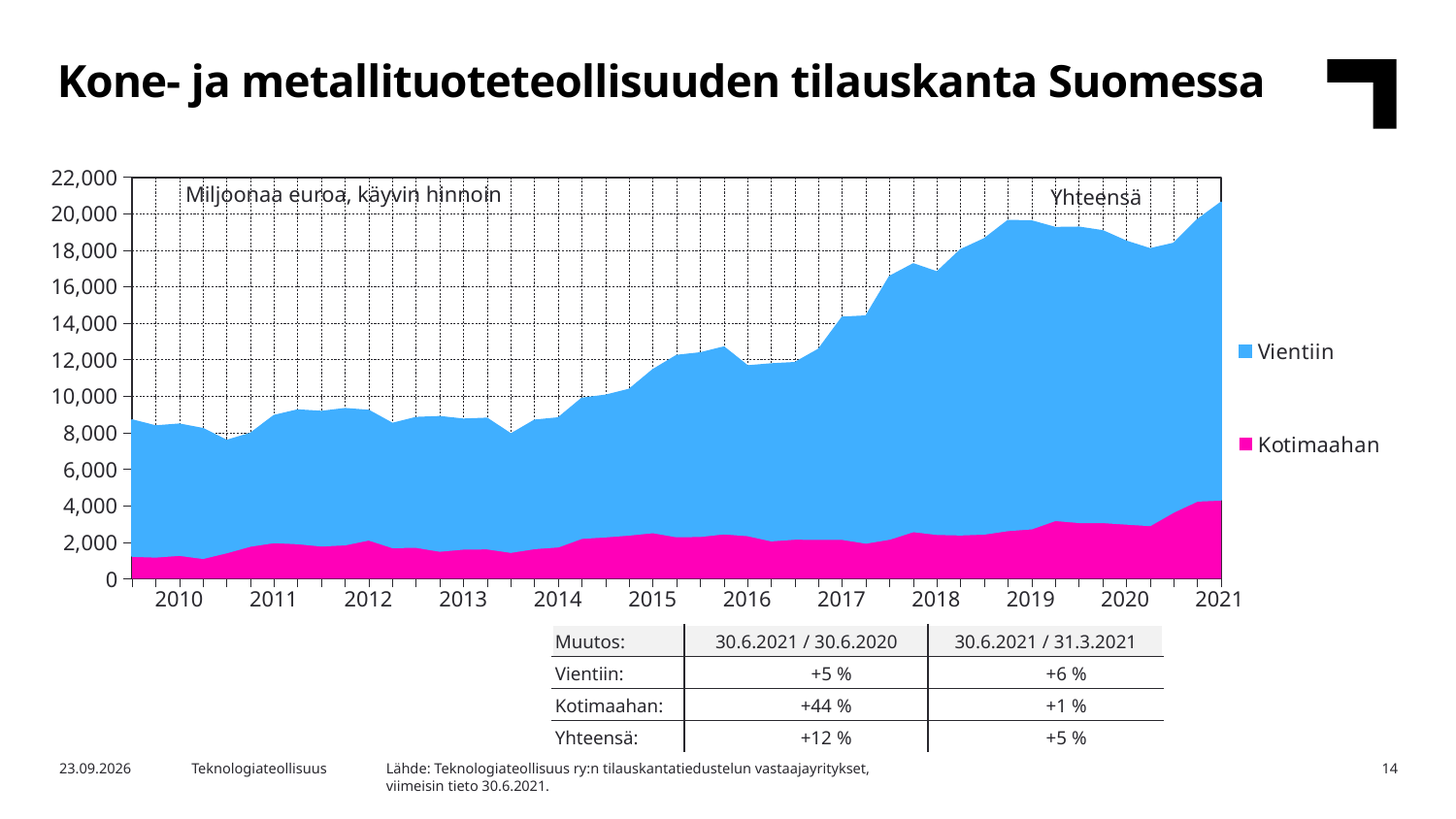
Is the Kotimaahan value at the start of 2010 greater or less than 2,000? less Is the total (Yhteensä) value at the start of 2018 greater or less than 16,000? greater At the end of the series in 2021, which is larger, Vientiin or Kotimaahan? Vientiin Does the total order backlog (Yhteensä) generally rise or fall from 2010 to 2021? rise What kind of chart is shown on the slide? Stacked area chart What are the two series named in the chart legend? Vientiin and Kotimaahan Is the total (Yhteensä) value at the start of 2019 greater or less than 20,000? less What unit label is shown inside the chart area? Miljoonaa euroa, käyvin hinnoin How many series does the chart legend list? 2 How many years are labelled on the x axis of the chart? 12